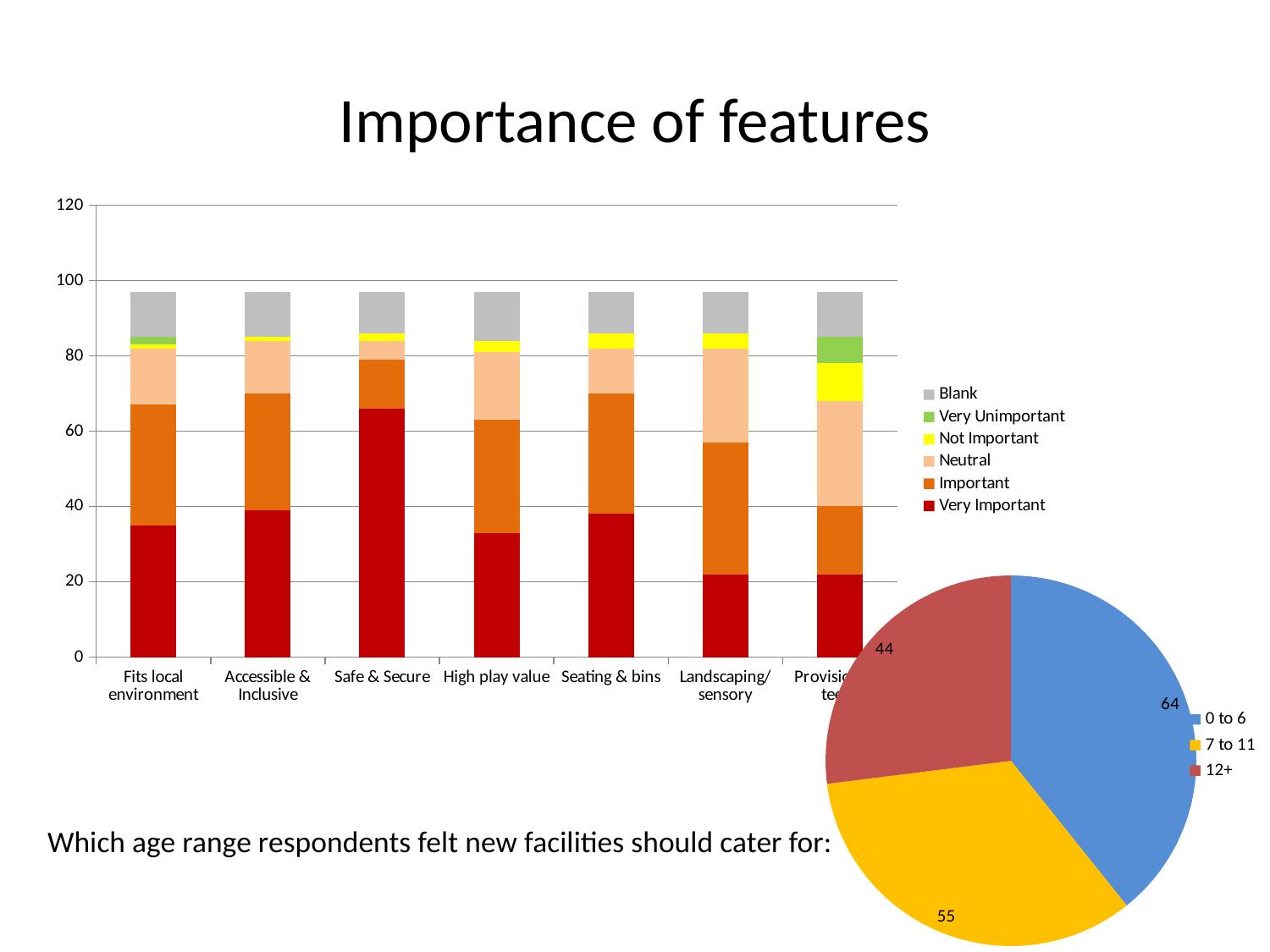
In the 'Importance of features' chart, which category has the highest Very Important value? Safe & Secure How many series does the legend of the 'Importance of features' chart list? 6 In the pie chart, which age range has the largest slice? 0 to 6 In the pie chart, what is the value for the 0 to 6 age range? 64 In the pie chart, what is the value for the 12+ age range? 44 In the pie chart, what is the difference between the values for 0 to 6 and 7 to 11? 9 In the pie chart, which age range has the smallest slice? 12+ In the pie chart, what is the value for the 7 to 11 age range? 55 What kind of chart is the 'Importance of features' chart? Stacked bar chart How many slices does the pie chart have? 3 In the 'Importance of features' chart, is the Very Important value for Safe & Secure greater or less than 60? greater In the 'Importance of features' chart, is the Very Important value for Landscaping/sensory greater or less than 40? less